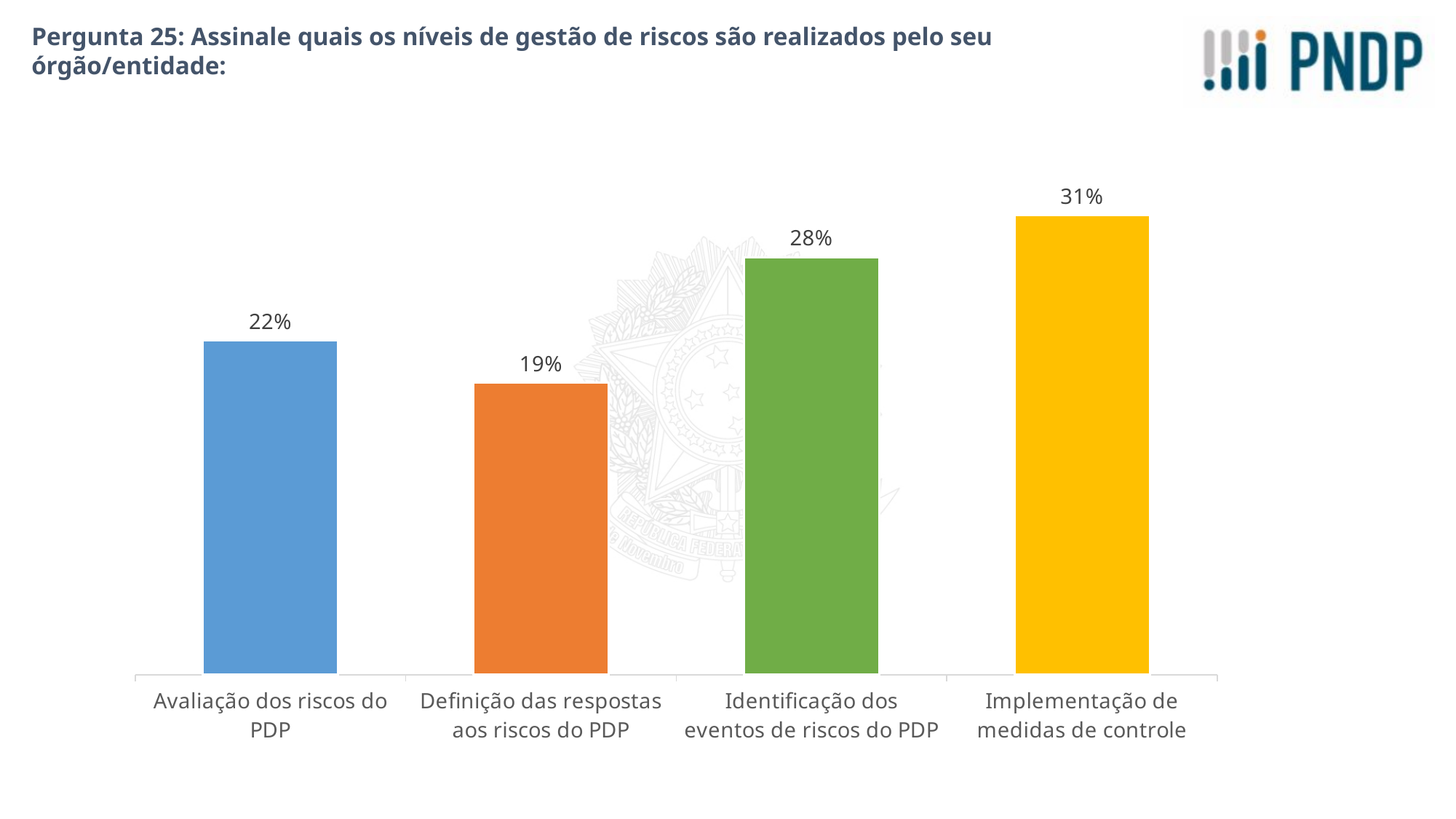
What is the value for 'Implementação de medidas de controle'? 31% What is the value for 'Definição das respostas aos riscos do PDP'? 19% What is the difference between the values for 'Implementação de medidas de controle' and 'Definição das respostas aos riscos do PDP'? 12% What is the value for 'Identificação dos eventos de riscos do PDP'? 28% What kind of chart is shown on the slide? Bar chart What colour is the bar for 'Identificação dos eventos de riscos do PDP'? Green Which category has the highest value? Implementação de medidas de controle What is the value for 'Avaliação dos riscos do PDP'? 22% How many categories are shown in the chart? 4 Which category has the lowest value? Definição das respostas aos riscos do PDP What is the difference between the values for 'Identificação dos eventos de riscos do PDP' and 'Avaliação dos riscos do PDP'? 6% Which is larger: the value for 'Avaliação dos riscos do PDP' or 'Definição das respostas aos riscos do PDP'? Avaliação dos riscos do PDP